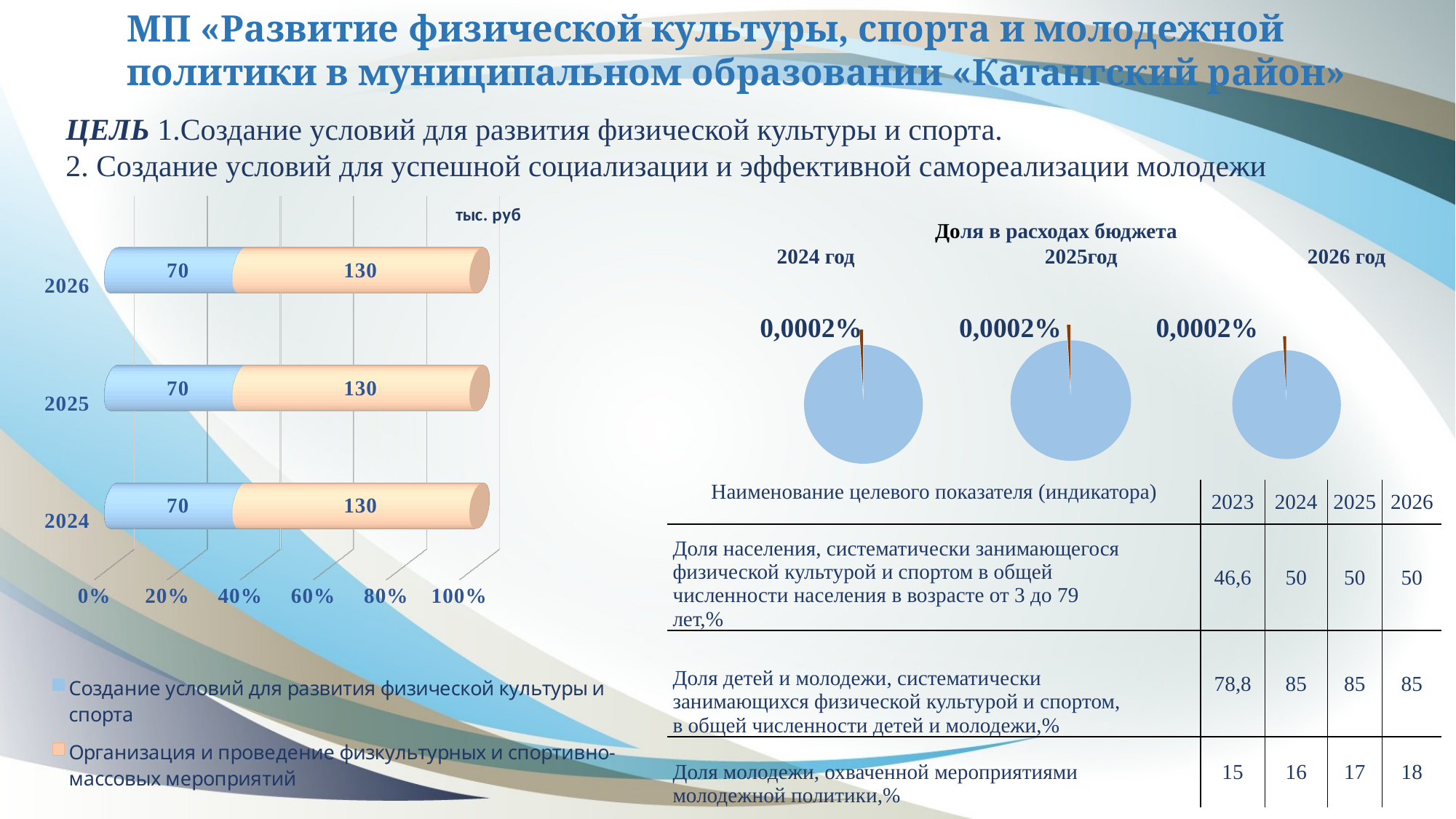
What type of chart is shown on the left of the slide? Stacked bar chart How many years (categories) are shown in the bar chart on the left? 3 In the bar chart on the left, which series has the larger value in 2026? Организация и проведение физкультурных и спортивно-массовых мероприятий How many series does the legend of the bar chart on the left list? 2 In the bar chart on the left, what is the value for 'Создание условий для развития физической культуры и спорта' in 2024? 70 In the bar chart on the left, what is the total of the stacked bar for 2025? 200 What unit is indicated at the top of the bar chart on the left? тыс. руб How many pie charts are shown under the title 'Доля в расходах бюджета'? 3 In the bar chart on the left, what is the value for 'Организация и проведение физкультурных и спортивно-массовых мероприятий' in 2026? 130 In the bar chart on the left, what is the difference between the two series values in 2024? 60 In the pie charts titled 'Доля в расходах бюджета', what share is shown for 2025? 0,0002% In the bar chart on the left, does the value for 'Создание условий для развития физической культуры и спорта' change from 2024 to 2026? No, it stays at 70